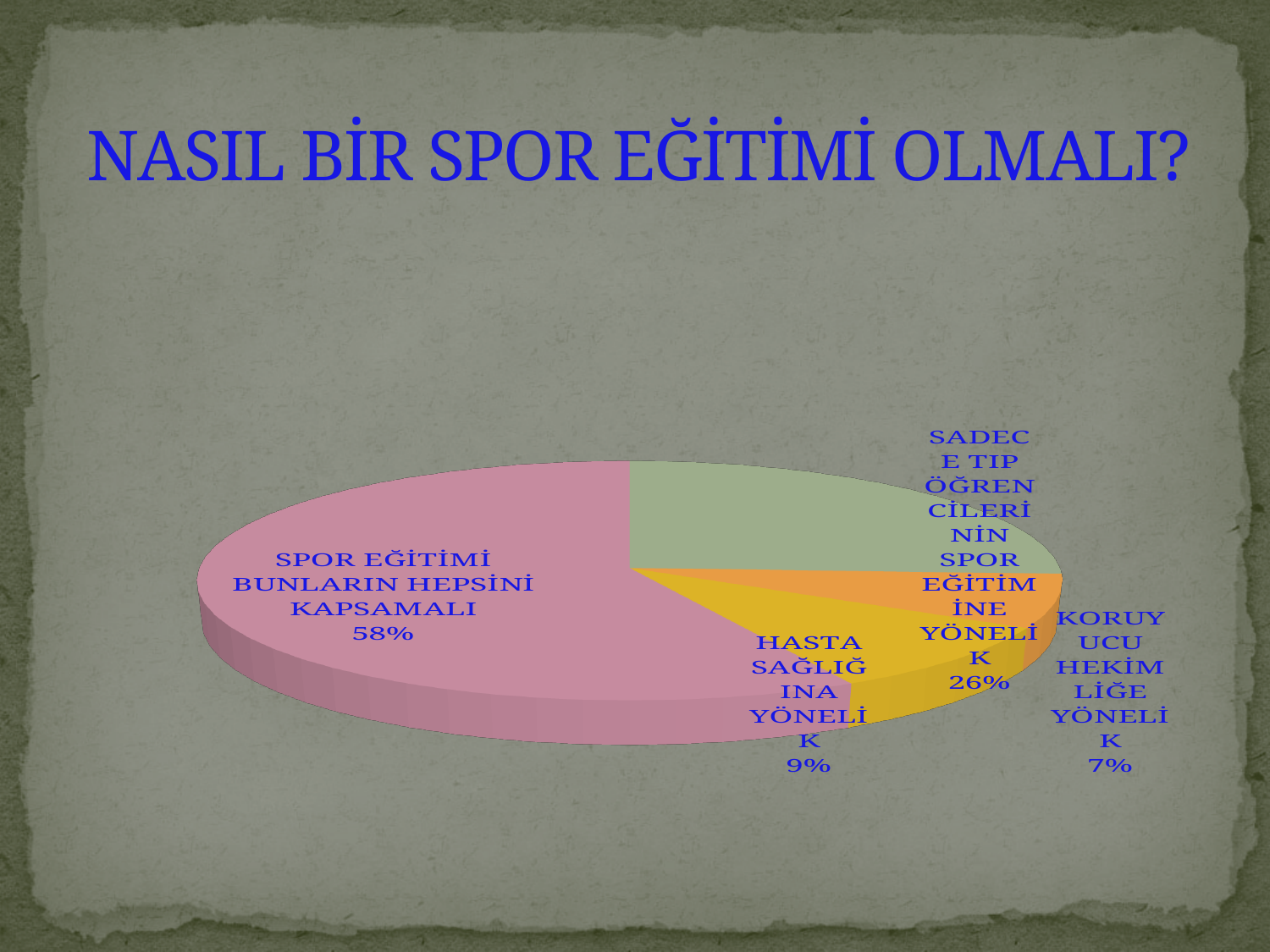
How many slices does the pie chart have? 4 What colour is the slice for "SPOR EĞİTİMİ BUNLARIN HEPSİNİ KAPSAMALI"? pink What percentage is shown for "KORUYUCU HEKİMLİĞE YÖNELİK"? 7% What is the difference in percentage points between "SPOR EĞİTİMİ BUNLARIN HEPSİNİ KAPSAMALI" and "SADECE TIP ÖĞRENCİLERİNİN SPOR EĞİTİMİNE YÖNELİK"? 32 What is the title of the slide? NASIL BİR SPOR EĞİTİMİ OLMALI? What type of chart is shown on the slide? pie chart What percentage is shown for "SPOR EĞİTİMİ BUNLARIN HEPSİNİ KAPSAMALI"? 58% What percentage is shown for "SADECE TIP ÖĞRENCİLERİNİN SPOR EĞİTİMİNE YÖNELİK"? 26% Which category has the smallest share of the pie? KORUYUCU HEKİMLİĞE YÖNELİK What percentage is shown for "HASTA SAĞLIĞINA YÖNELİK"? 9% Which is larger: the share for "HASTA SAĞLIĞINA YÖNELİK" or for "KORUYUCU HEKİMLİĞE YÖNELİK"? HASTA SAĞLIĞINA YÖNELİK Which category has the largest share of the pie? SPOR EĞİTİMİ BUNLARIN HEPSİNİ KAPSAMALI